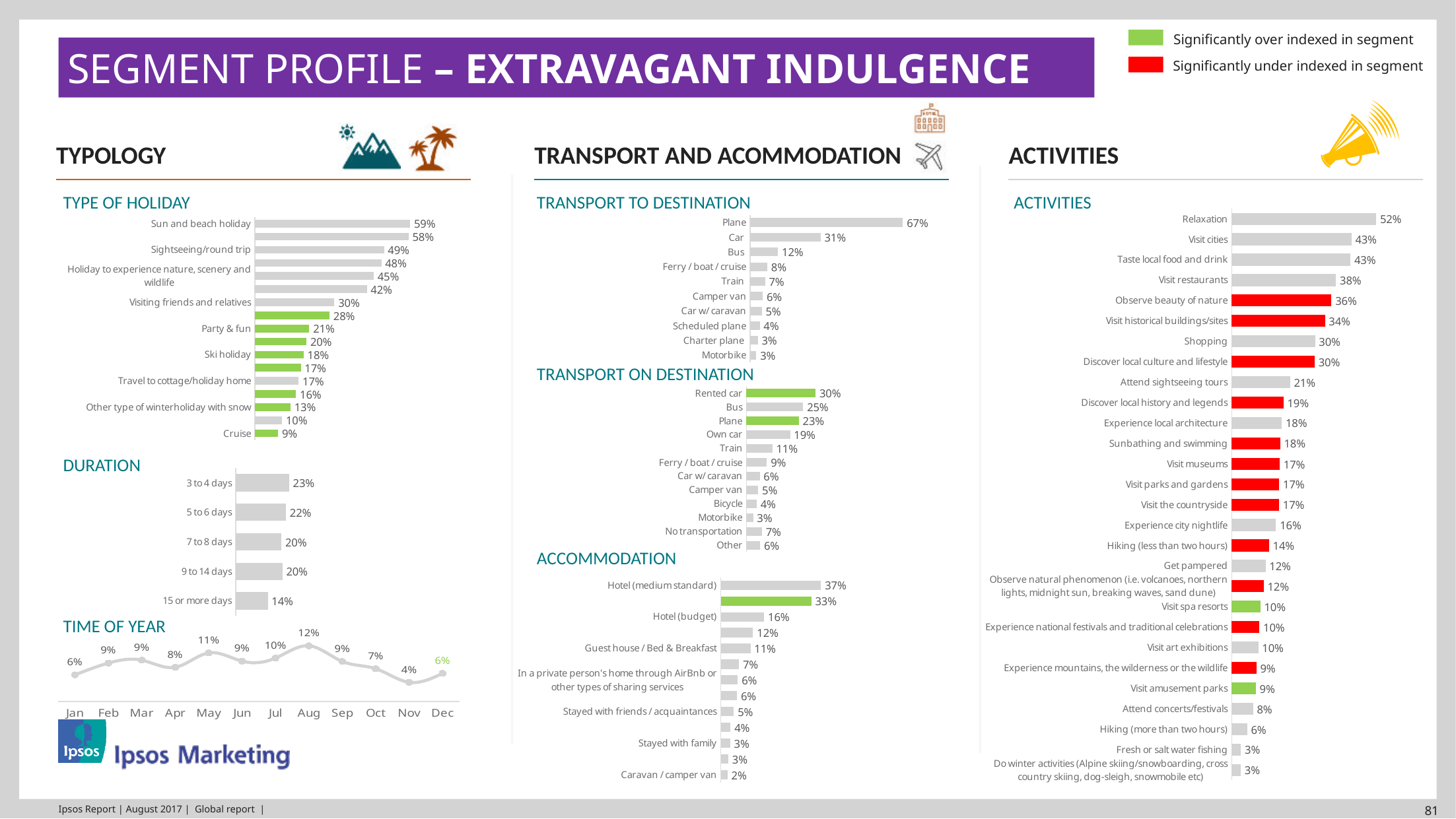
In the Time of Year chart, which month has the lowest value? Nov In the Activities chart, what is the value for Relaxation? 52% How many categories does the Duration chart show? 5 In the Transport on Destination chart, what is the value for Rented car? 30% In the Transport on Destination chart, which is larger, Bus or Own car? Bus In the Transport to Destination chart, what is the difference between Plane and Car? 36% What kind of chart is the Time of Year chart? Line chart In the Type of Holiday chart, what is the value for Cruise? 9% In the Time of Year chart, which month has the highest value? Aug In the Transport to Destination chart, which category has the highest value? Plane In the Transport to Destination chart, what is the value for Plane? 67% In the Duration chart, what is the value for 15 or more days? 14%